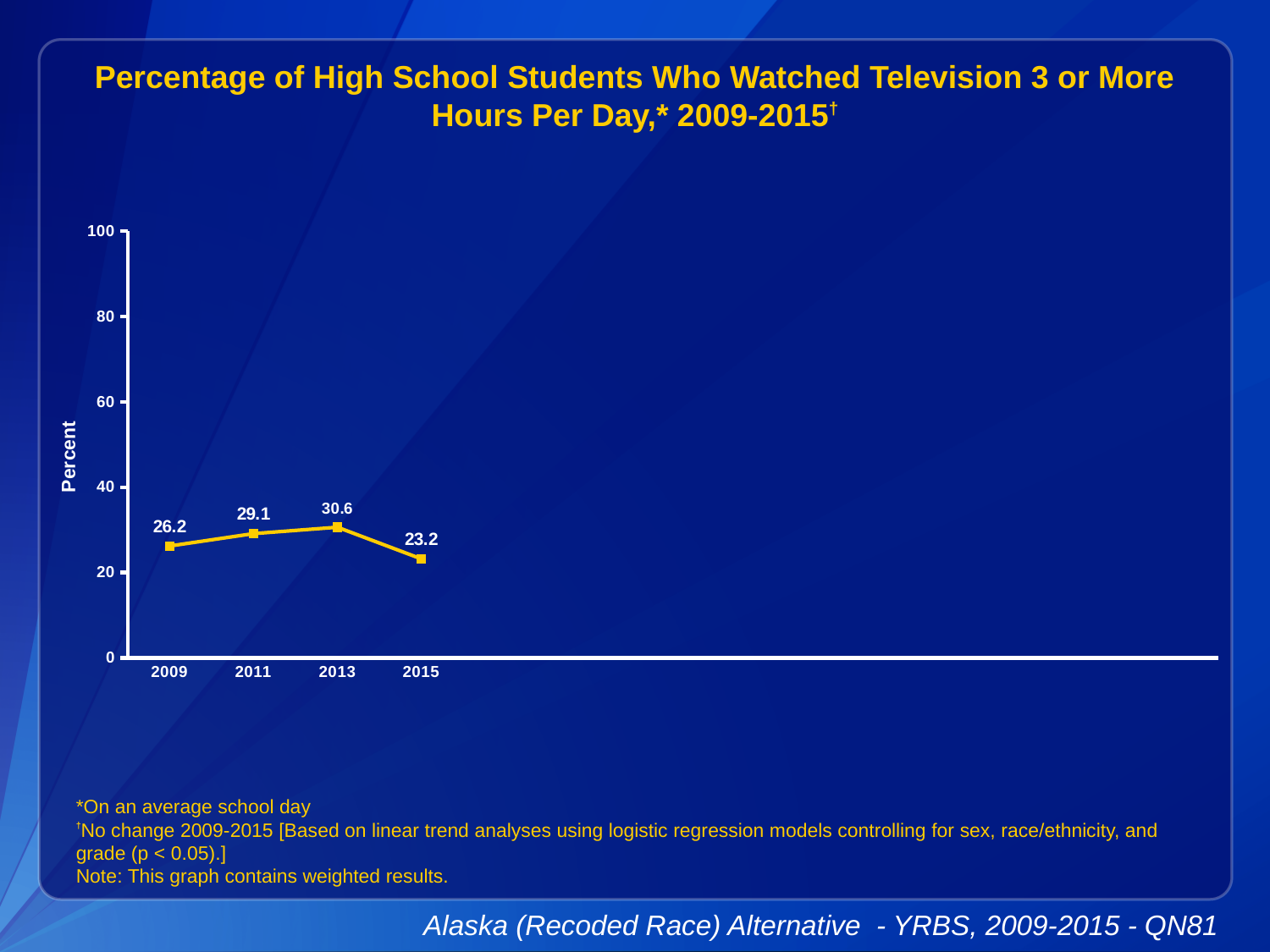
Which year has the lowest percentage? 2015 Which year has a larger value, 2009 or 2011? 2011 What is the label on the vertical axis? Percent What kind of chart is shown on the slide? line chart Is the value for 2011 greater or less than 40? less What is the value plotted for 2015? 23.2 What percentage of high school students watched television 3 or more hours per day in 2009? 26.2 Which year has the highest percentage? 2013 Does the value rise or fall from 2013 to 2015? fall What is the difference between the 2013 value and the 2015 value? 7.4 What is the value plotted for 2013? 30.6 How many years are plotted on the chart? 4